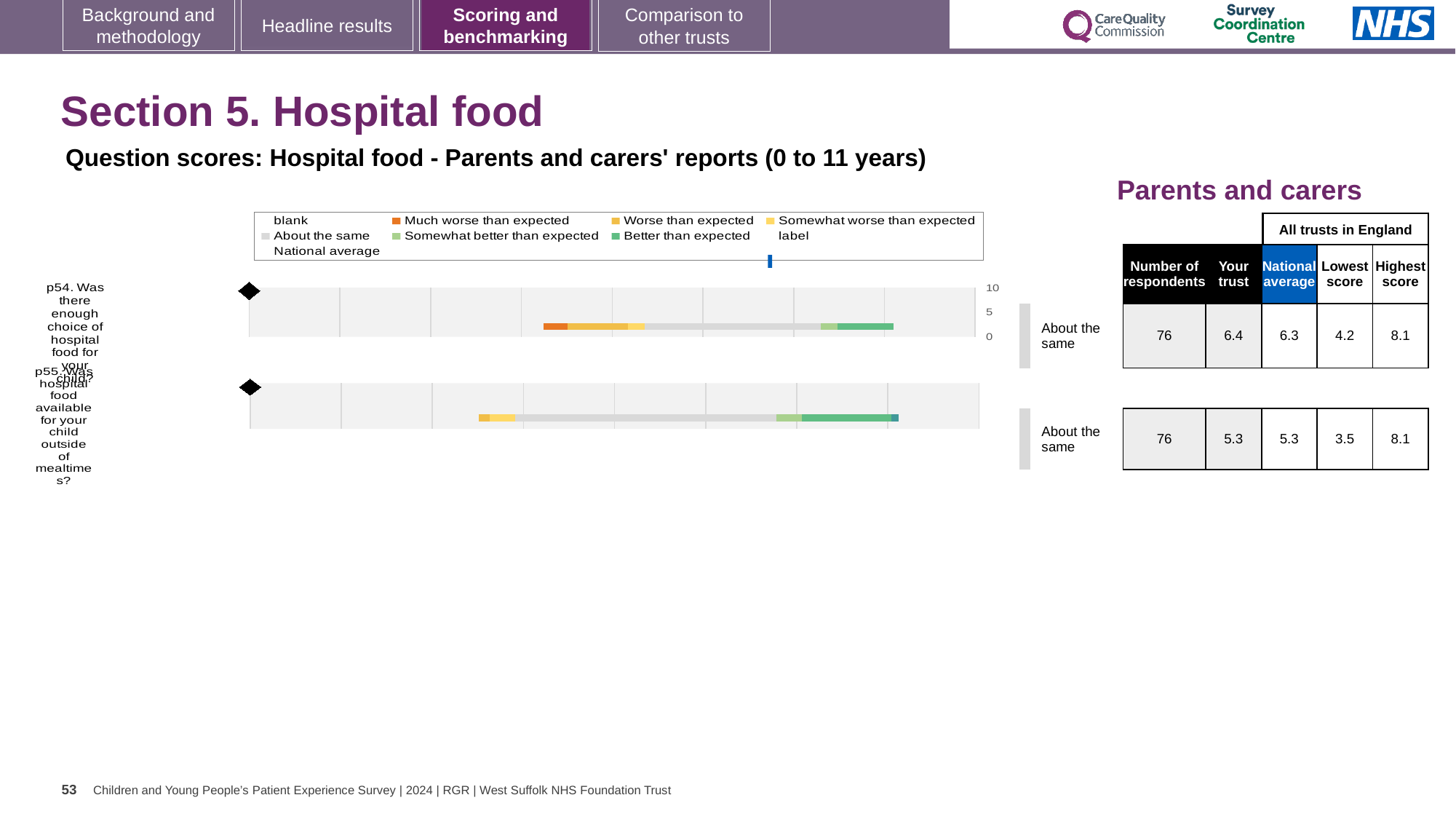
Which question has the higher 'Your trust' score, p54 or p55? p54 What is the national average score for p55 (hospital food available outside of mealtimes)? 5.3 How many respondents answered p54? 76 What benchmark category is shown for p55? About the same What kind of chart is used to show the question scores for hospital food? bar chart How many questions are plotted in the hospital food chart? 2 What is the highest value shown on the score axis of the chart? 10 What is the 'Your trust' score for p54 (enough choice of hospital food for your child)? 6.4 What is the difference between the 'Your trust' score and the national average for p54? 0.1 What is the lowest score among all trusts in England for p55? 3.5 What is the subtitle of the chart on this slide? Question scores: Hospital food - Parents and carers' reports (0 to 11 years) What is the highest score among all trusts in England for p54? 8.1